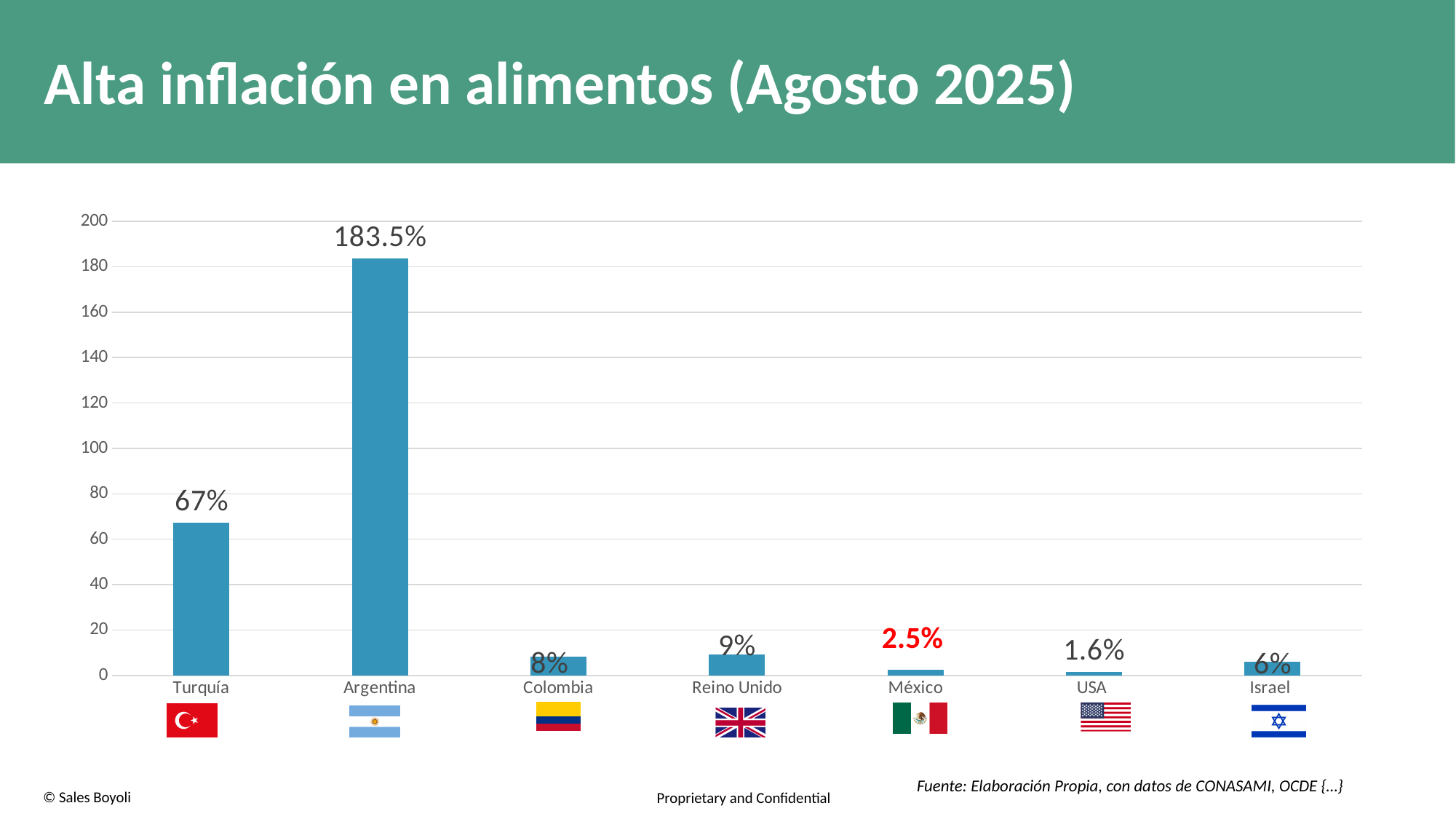
Which country has the highest value? Argentina What is the value for México? 2.5% Which is larger, the value for Reino Unido or the value for Colombia? Reino Unido What is the value for Turquía? 67% How many countries are shown in the chart? 7 What kind of chart is shown on the slide? Bar chart What is the title of the slide? Alta inflación en alimentos (Agosto 2025) What is the value for USA? 1.6% What is the difference between the values for Argentina and Turquía? 116.5% Is the value for Turquía greater or less than 60? greater Which country has the lowest value? USA What is the value for Argentina? 183.5%